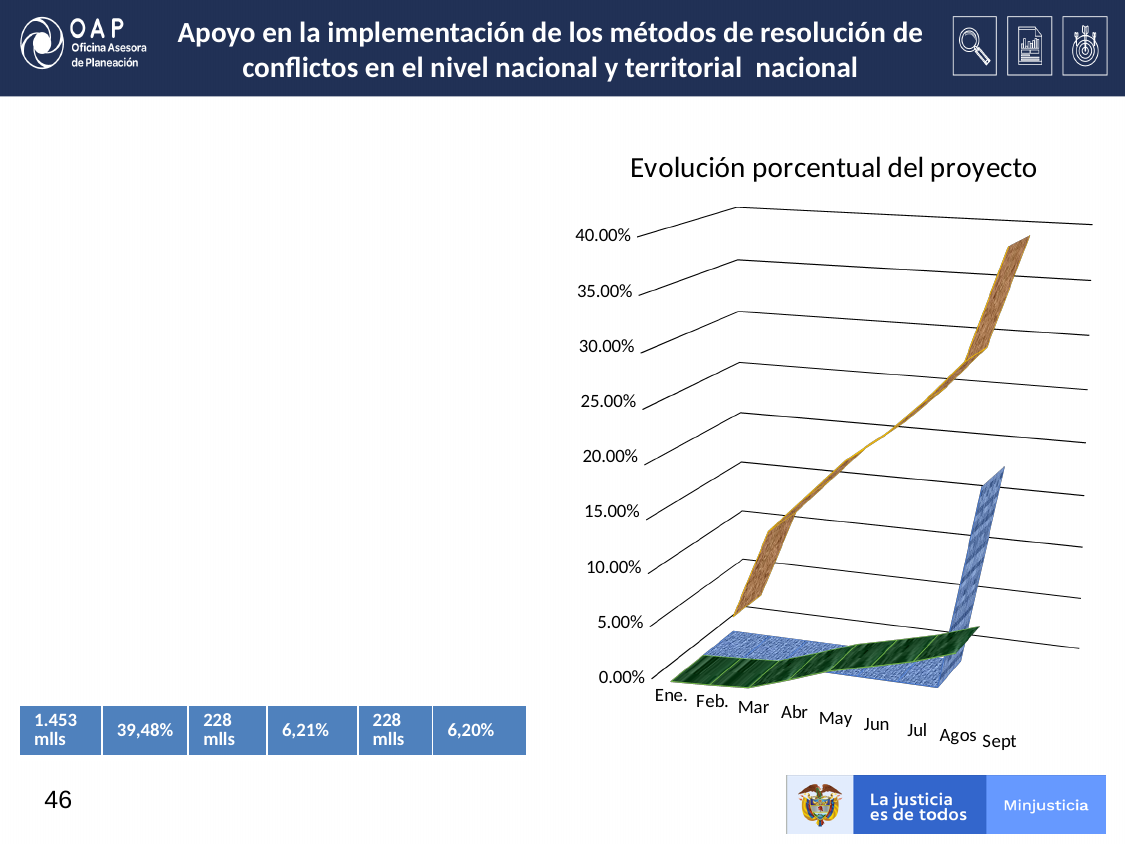
How many months are shown on the x axis of the chart? 9 Which month is the last category on the x axis of the chart? Sept How many lines (series) are plotted in the chart? 3 Does the orange line rise or fall from Ene. to Sept? rises Is the value of the orange line at Ene. greater or less than 5.00%? less What is the title of the chart? Evolución porcentual del proyecto What kind of chart is shown on the slide? line chart What is the highest value shown on the vertical axis of the chart? 40.00% Is the value of the green line at Ene. greater or less than 5.00%? less